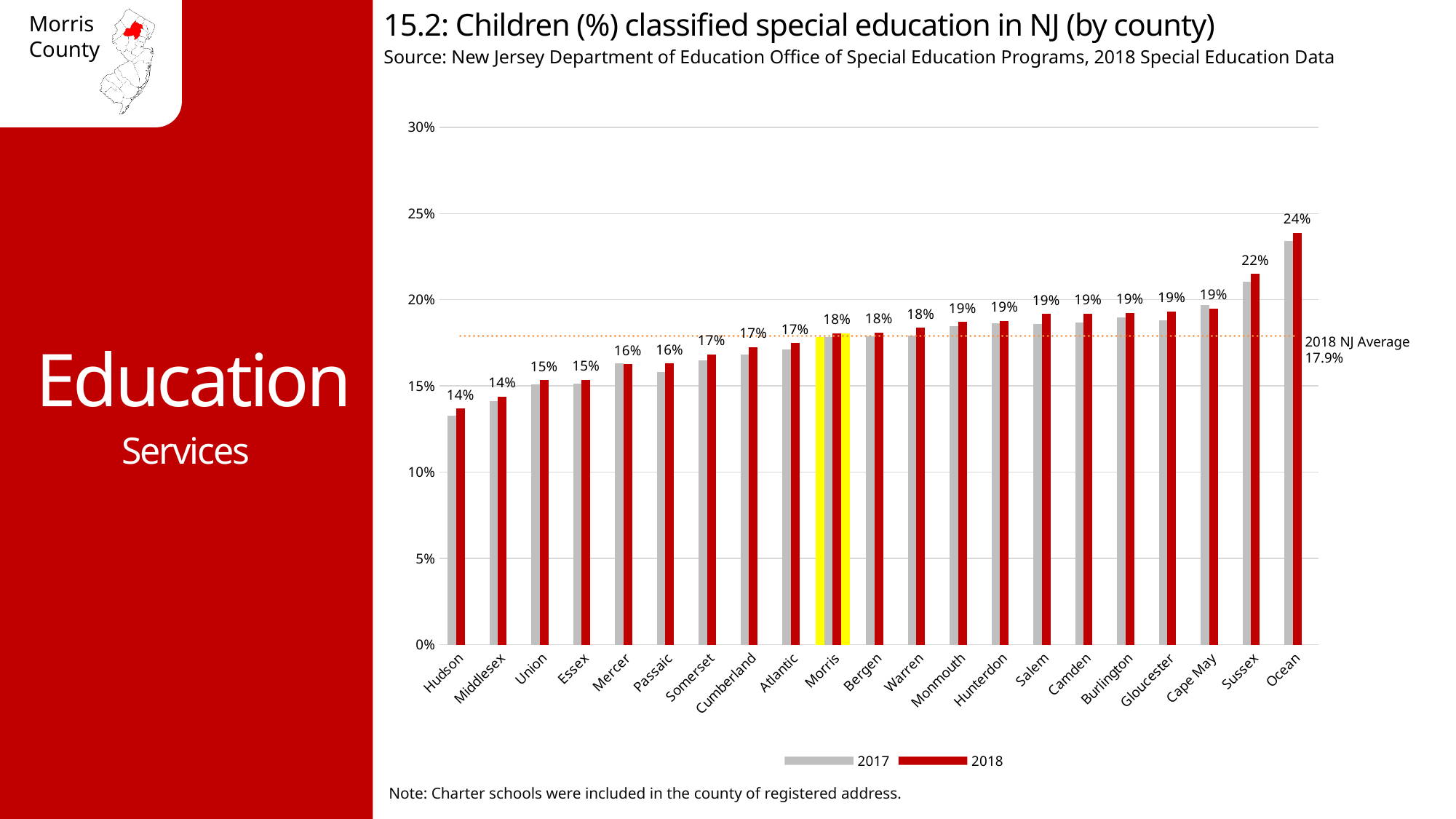
What kind of chart is shown on the slide? bar chart How many counties are shown on the x axis? 21 What is the 2018 value labelled for Morris? 18% Which county has the highest 2018 value? Ocean What is the 2018 value labelled for Mercer? 16% What is the difference between the 2018 labelled values for Ocean and Hudson? 10 percentage points Is the 2017 value for Ocean greater or less than 20%? greater What is the 2018 value labelled for Sussex? 22% What 2018 NJ average is marked by the dotted line? 17.9% Which has the larger 2018 value, Sussex or Cape May? Sussex Do the 2018 values generally rise or fall from left to right along the x axis? rise How many series does the legend list? 2